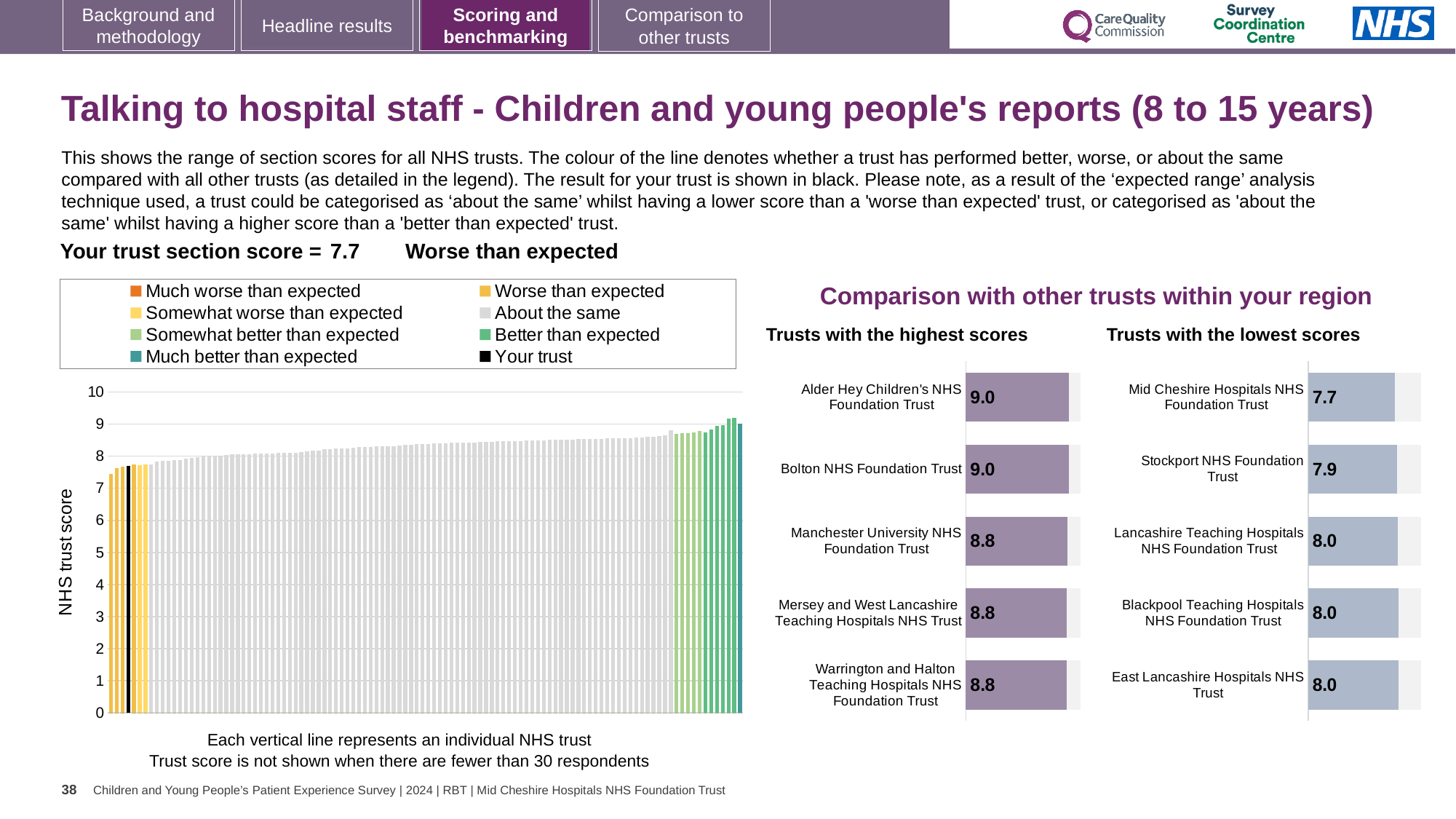
How many entries does the legend of the large chart on the left list? 8 In the 'Trusts with the highest scores' chart, what is the difference between the scores of Bolton NHS Foundation Trust and Warrington and Halton Teaching Hospitals NHS Foundation Trust? 0.2 In the 'Trusts with the lowest scores' chart, what is the difference between the scores of Stockport NHS Foundation Trust and Mid Cheshire Hospitals NHS Foundation Trust? 0.2 How many trusts are listed in the 'Trusts with the highest scores' chart? 5 In the large chart on the left showing the range of section scores, do the bar values rise or fall from left to right? rise In the 'Trusts with the highest scores' chart, what is the score for Alder Hey Children's NHS Foundation Trust? 9.0 In the large chart on the left showing the range of section scores, is the value for 'Your trust' (the black bar) greater or less than 8? less What kind of chart is the large chart on the left showing the range of section scores? bar chart In the 'Trusts with the lowest scores' chart, what is the score for Stockport NHS Foundation Trust? 7.9 In the 'Trusts with the lowest scores' chart, which trust has the lowest score? Mid Cheshire Hospitals NHS Foundation Trust In the 'Trusts with the lowest scores' chart, which has the larger score: Stockport NHS Foundation Trust or Mid Cheshire Hospitals NHS Foundation Trust? Stockport NHS Foundation Trust In the 'Trusts with the highest scores' chart, what is the score for Manchester University NHS Foundation Trust? 8.8